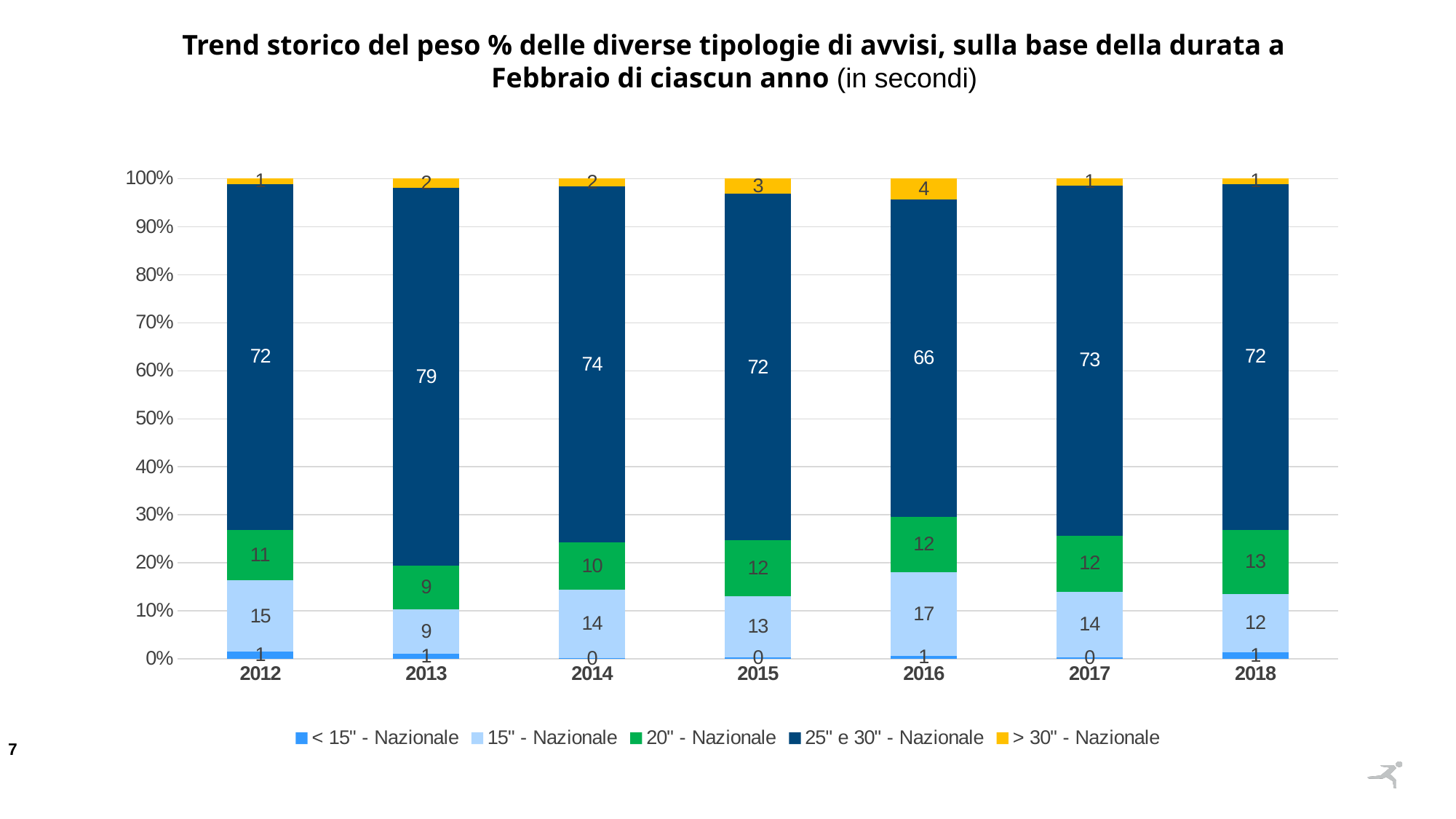
How many years are shown on the x axis? 7 In which year is the 25'' e 30'' - Nazionale value highest? 2013 What is the difference between the 25'' e 30'' - Nazionale values for 2013 and 2016? 13 Which series is shown in yellow in the legend? > 30'' - Nazionale What is the value of the > 30'' - Nazionale series for 2015? 3 What kind of chart is shown on the slide? Stacked bar chart What is the value of the 20'' - Nazionale series for 2018? 13 How many series does the legend list? 5 What is the value of the 15'' - Nazionale series for 2016? 17 Which is larger, the 15'' - Nazionale value for 2012 or for 2013? 2012 In which year is the 25'' e 30'' - Nazionale value lowest? 2016 What is the value of the 25'' e 30'' - Nazionale series for 2013? 79